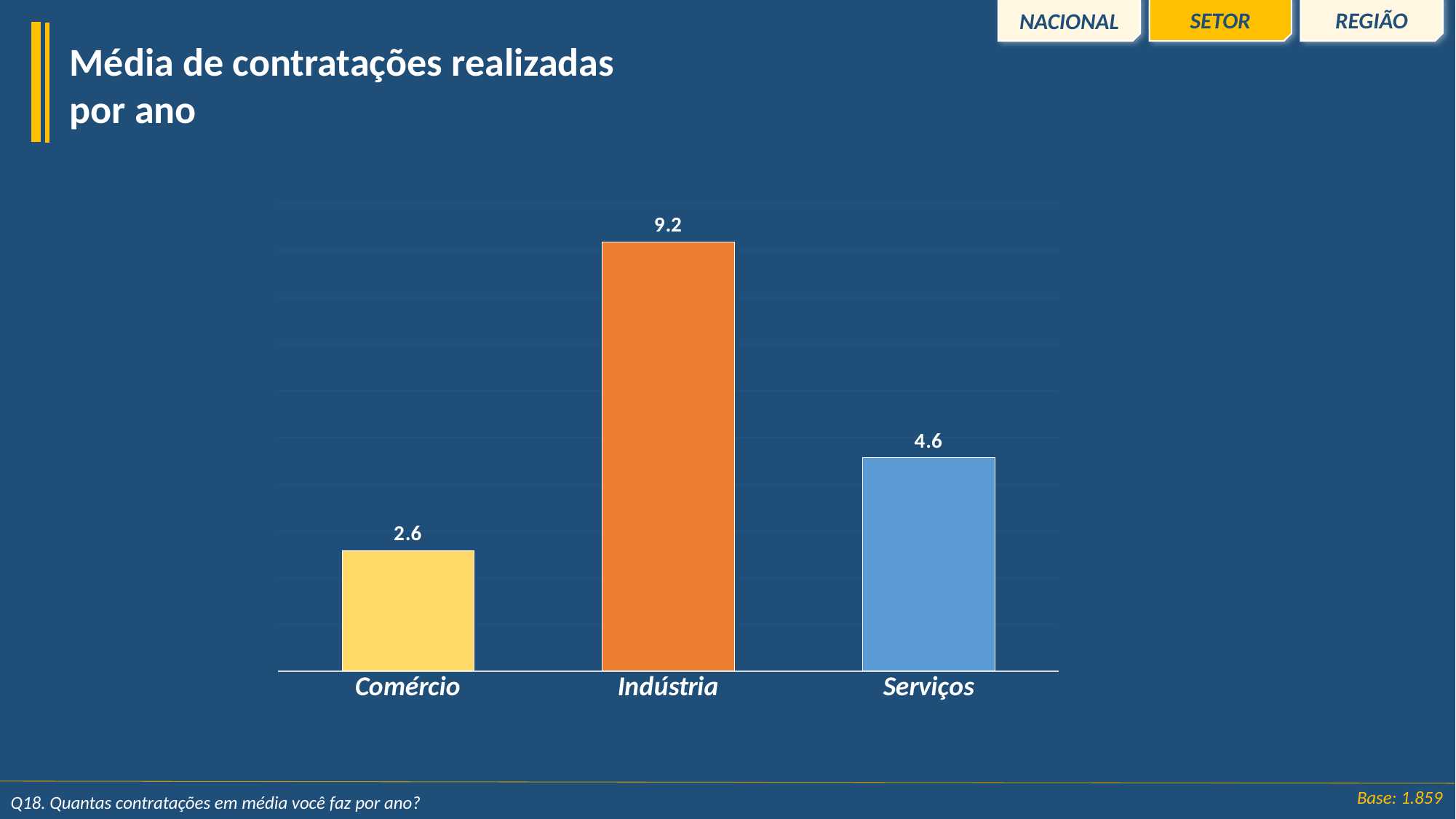
Which sector has the highest average number of hires per year? Indústria What is the title of the chart on the slide? Média de contratações realizadas por ano What kind of chart is shown on the slide? Bar chart What is the value shown for Serviços? 4.6 What is the value shown for Comércio? 2.6 Which is larger, the value for Serviços or the value for Comércio? Serviços What is the difference between the values for Indústria and Serviços? 4.6 What colour is the bar for Indústria? Orange What is the difference between the values for Serviços and Comércio? 2.0 What is the average number of hires per year for Indústria? 9.2 How many sectors are shown in the chart? 3 Which sector has the lowest average number of hires per year? Comércio